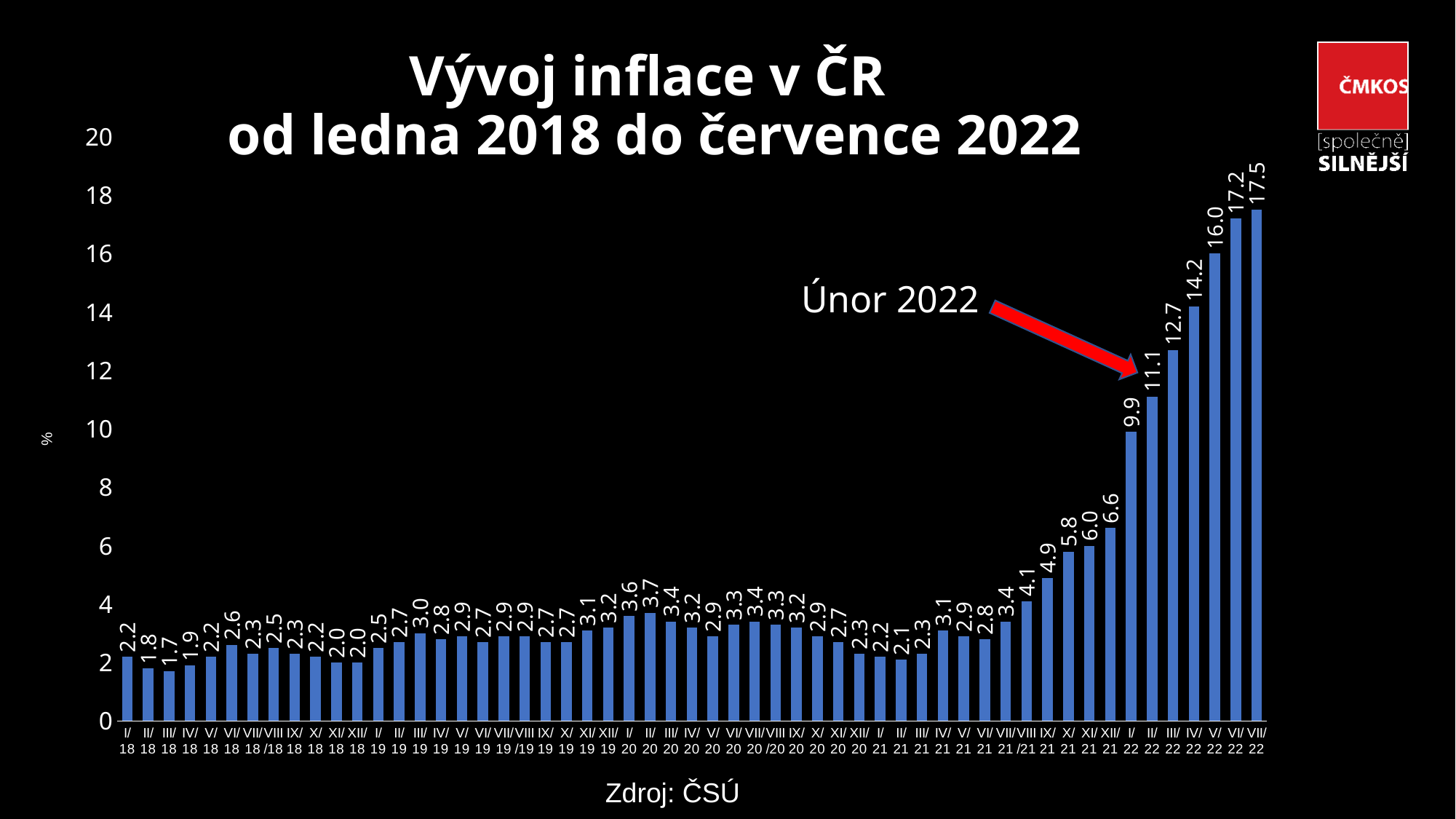
Which month has the highest value in the chart? VII/22 What is the title of the chart? Vývoj inflace v ČR od ledna 2018 do července 2022 What value is labelled on the bar for II/22, the month marked 'Únor 2022'? 11.1 Which is larger, the value for II/20 or the value for XII/21? XII/21 How many bars are plotted in the chart? 55 Which month has the lowest value in the chart? III/18 What is the difference between the values for VII/22 and I/22? 7.6 What kind of chart is shown on the slide? bar chart Do the values rise or fall from I/22 to VII/22? rise What is the value shown for I/18? 2.2 Is the value for V/22 greater or less than 14? greater What is the inflation value shown for VII/22? 17.5